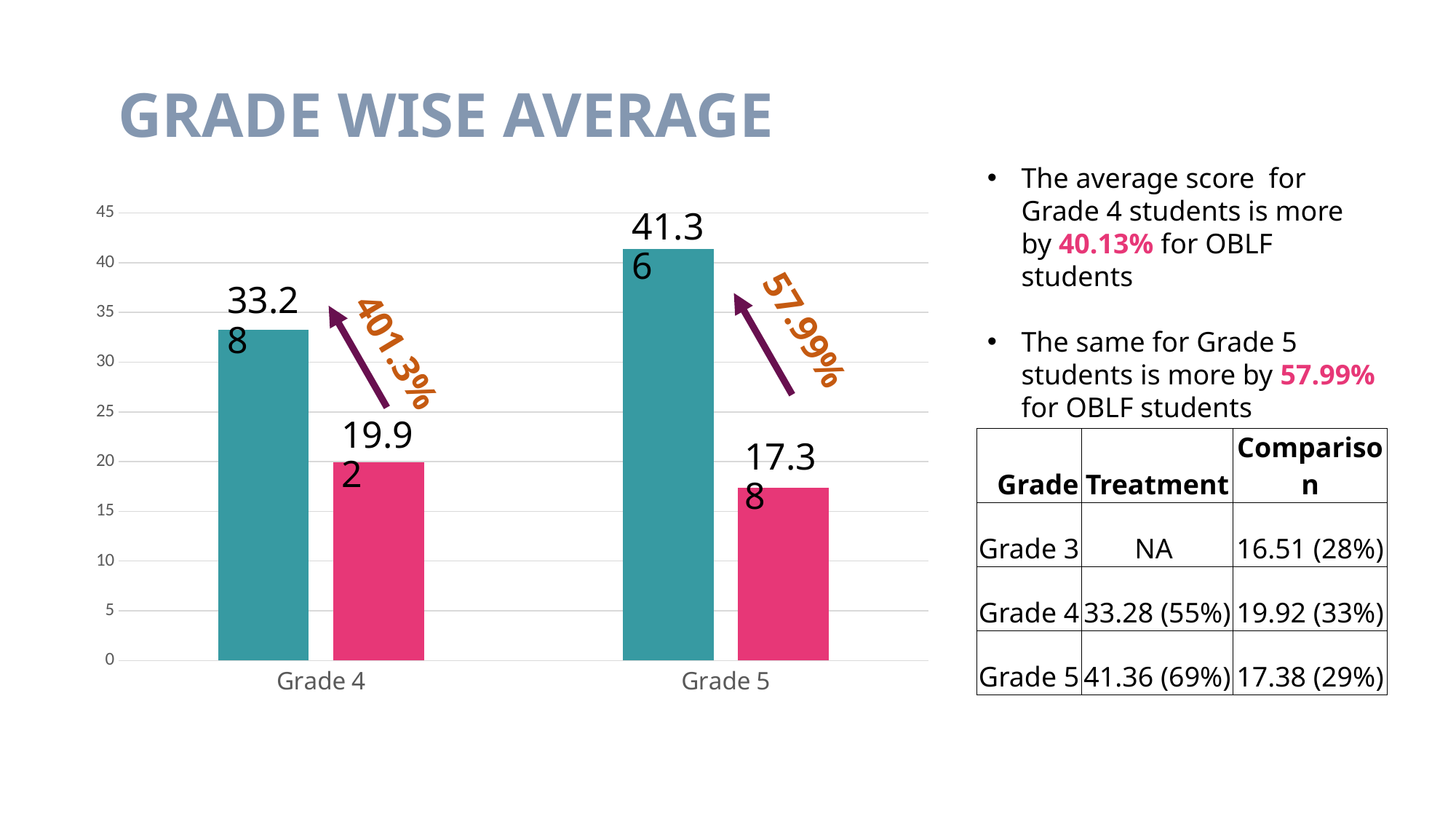
Which bar in the chart has the lowest value? Pink bar for Grade 5 (17.38) What type of chart is shown on the slide? Bar chart What is the difference between the teal and pink bars for Grade 4? 13.36 What is the value of the pink bar for Grade 5? 17.38 What is the value of the teal bar for Grade 5? 41.36 Is the value of the teal bar for Grade 5 greater or less than 40? greater What is the value of the pink bar for Grade 4? 19.92 What is the difference between the teal and pink bars for Grade 5? 23.98 Which bar in the chart has the highest value? Teal bar for Grade 5 (41.36) What is the value of the teal bar for Grade 4? 33.28 How many grade categories are shown on the x axis of the chart? 2 Which is larger, the pink bar for Grade 4 or the pink bar for Grade 5? Pink bar for Grade 4